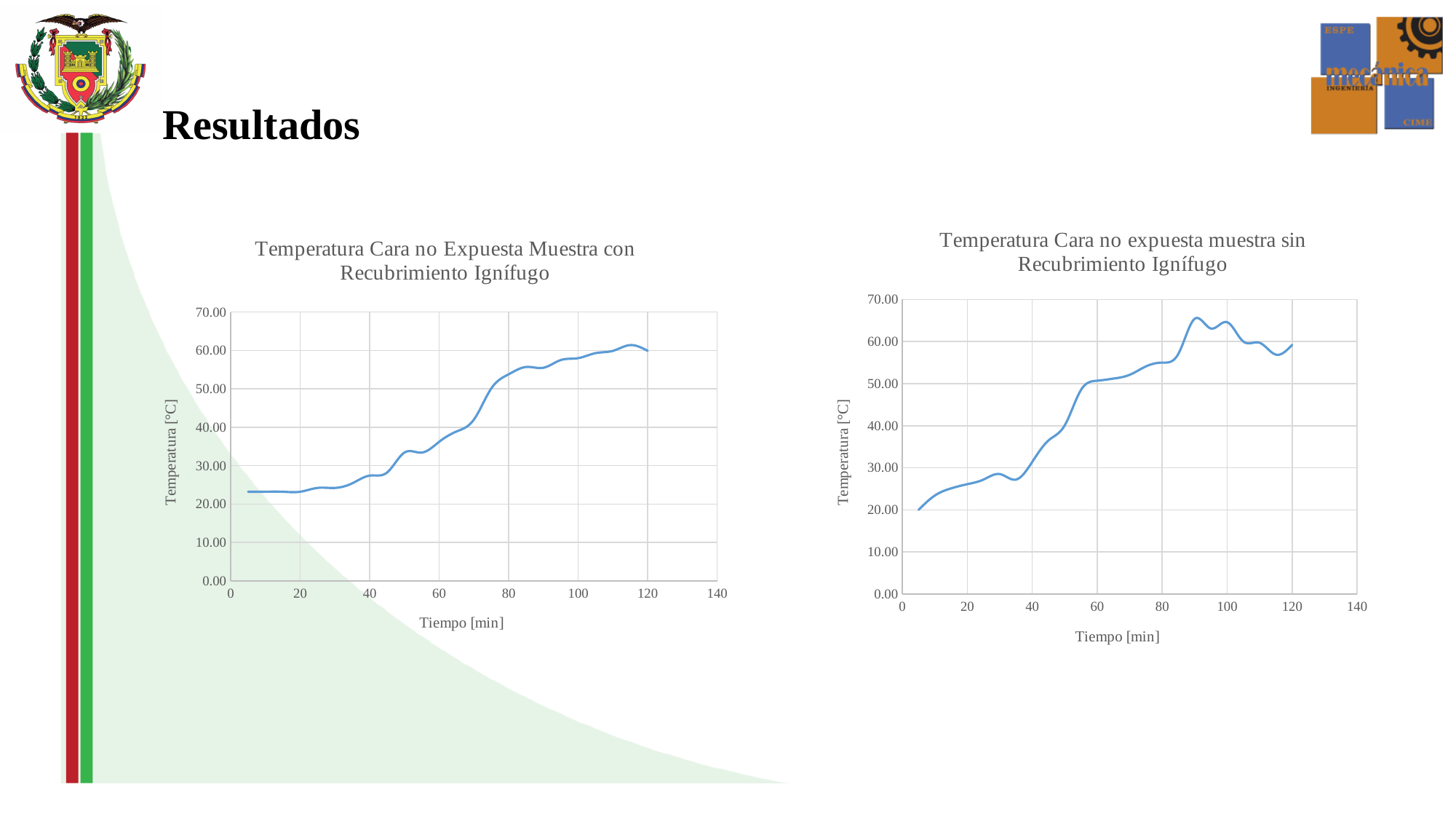
What is the label of the y axis on the right chart (sin Recubrimiento Ignífugo)? Temperatura [°C] In the left chart (con Recubrimiento Ignífugo), is the temperature at 20 minutes greater or less than 30? less In the right chart (sin Recubrimiento Ignífugo), is the temperature at 40 minutes greater or less than 40? less How many charts are shown on the slide? 2 What is the label of the x axis on the left chart (con Recubrimiento Ignífugo)? Tiempo [min] In the right chart (sin Recubrimiento Ignífugo), is the temperature at 90 minutes greater or less than 60? greater In the right chart (sin Recubrimiento Ignífugo), does the temperature generally rise or fall between 0 and 80 minutes? Rise What type of chart is the left chart titled "Temperatura Cara no Expuesta Muestra con Recubrimiento Ignífugo"? Line chart In the left chart (con Recubrimiento Ignífugo), does the temperature generally rise or fall as time increases from 0 to 120 minutes? Rise What type of chart is the right chart titled "Temperatura Cara no expuesta muestra sin Recubrimiento Ignífugo"? Line chart